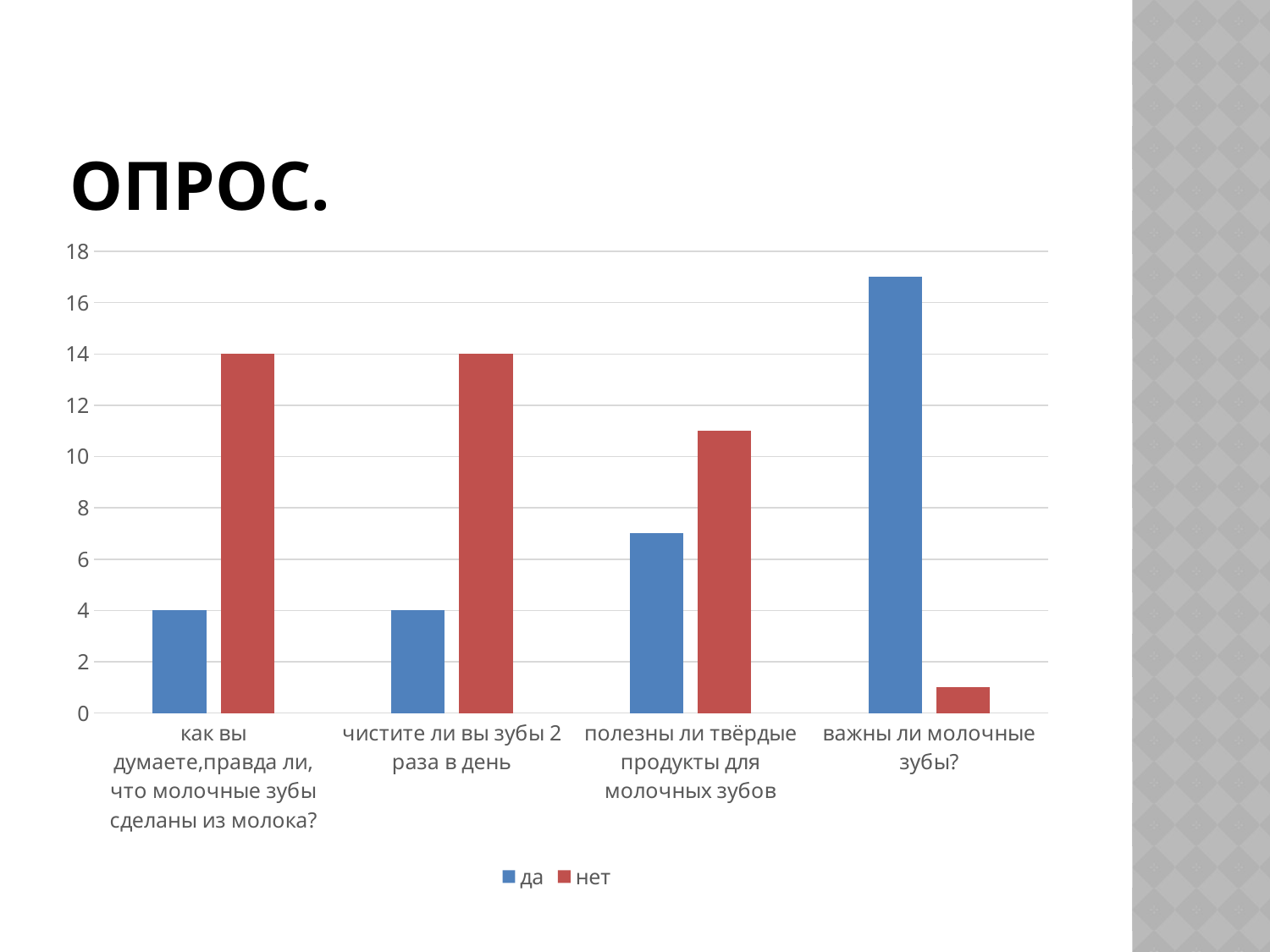
Is the value of "да" for "полезны ли твёрдые продукты для молочных зубов" greater or less than 6? greater How many series does the legend list? 2 For which category is the "да" value highest? важны ли молочные зубы? What kind of chart is shown on the slide? bar chart How many question categories are shown on the x axis? 4 What is the value of "нет" for "чистите ли вы зубы 2 раза в день"? 14 Is the value of "да" for "важны ли молочные зубы?" greater or less than 16? greater For "полезны ли твёрдые продукты для молочных зубов", which is larger, "да" or "нет"? нет What is the value of "да" for "чистите ли вы зубы 2 раза в день"? 4 For which category is the "нет" value lowest? важны ли молочные зубы? Is the value of "нет" for "важны ли молочные зубы?" greater or less than 2? less What is the value of "нет" for "как вы думаете,правда ли, что молочные зубы сделаны из молока?"? 14